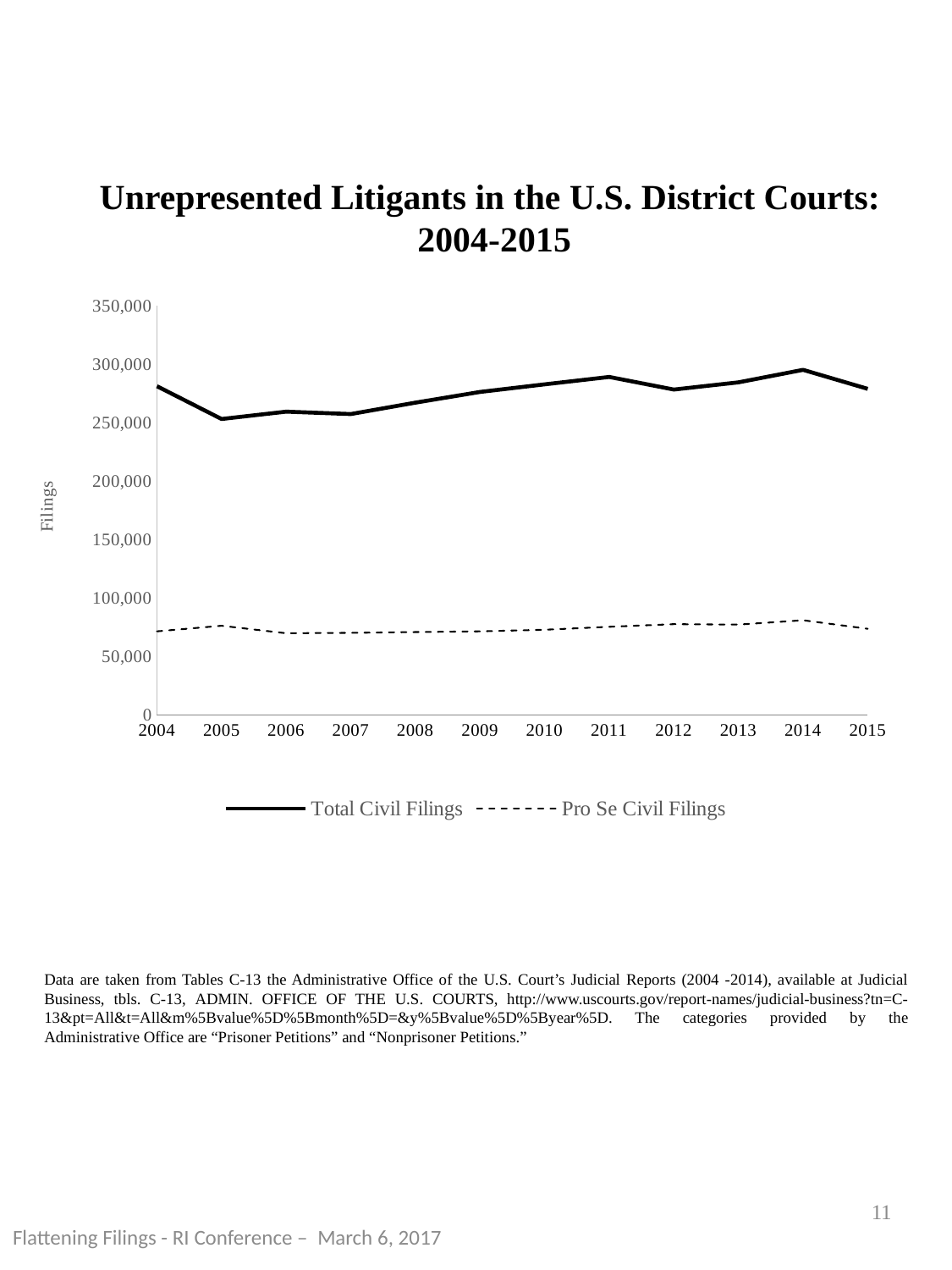
How many series does the legend list? 2 Is the value for Total Civil Filings in 2004 greater or less than 250,000? greater Is the value for Pro Se Civil Filings in 2010 greater or less than 100,000? less Which is larger: Total Civil Filings in 2014 or Total Civil Filings in 2005? 2014 How many years are plotted along the x axis? 12 In which year is Total Civil Filings lowest? 2005 Do Total Civil Filings rise or fall from 2007 to 2011? rise What is the label on the vertical axis? Filings In which year is Total Civil Filings highest? 2014 What kind of chart is shown on the slide? line chart Is the value for Total Civil Filings in 2005 greater or less than 300,000? less